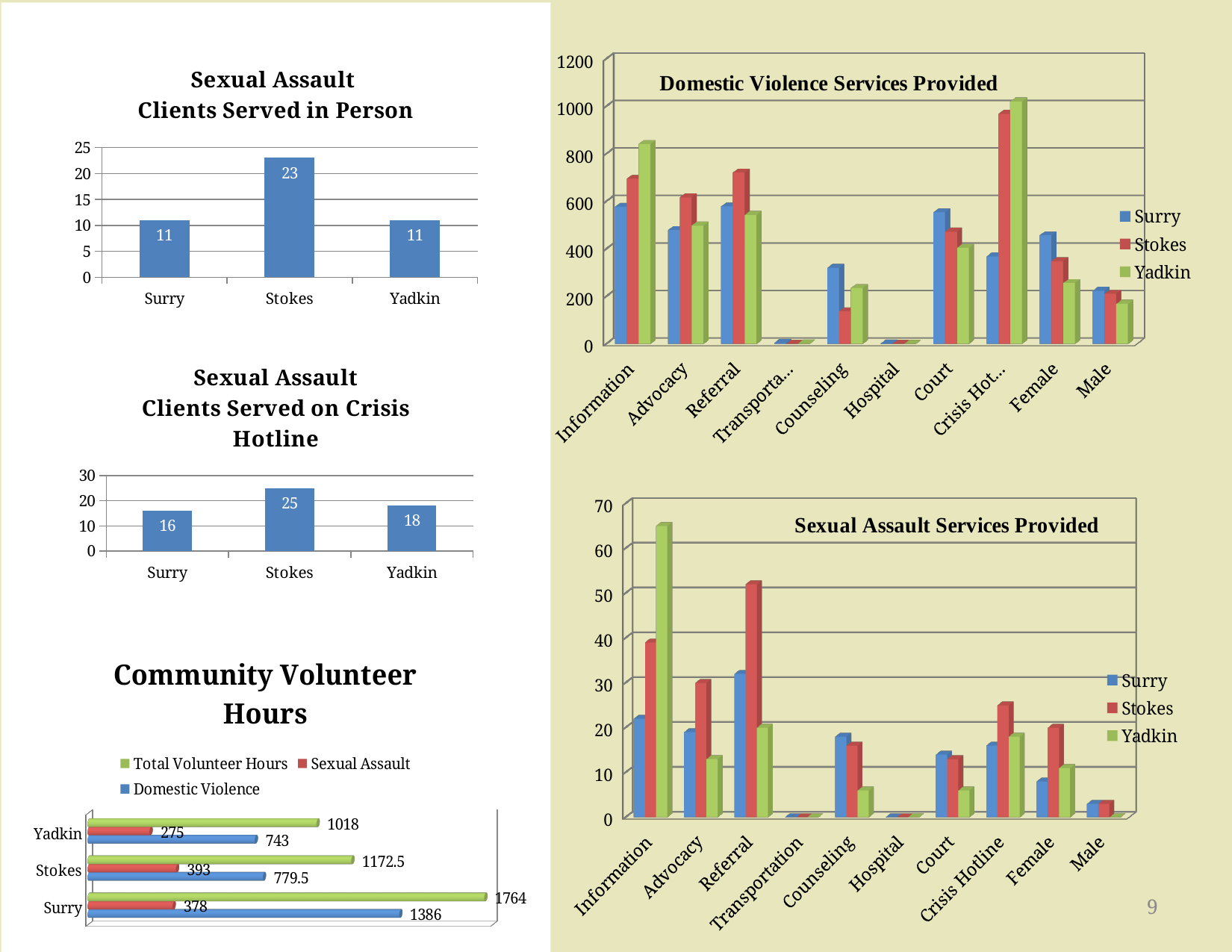
In the 'Domestic Violence Services Provided' chart, how many categories are shown on the x axis? 10 In the 'Community Volunteer Hours' chart, which is larger: the Sexual Assault value for Stokes or for Yadkin? Stokes In the 'Sexual Assault Services Provided' chart, is the Yadkin value for Information greater or less than 60? greater In the 'Sexual Assault Clients Served on Crisis Hotline' chart, what is the value for Yadkin? 18 In the 'Community Volunteer Hours' chart, how many series does the legend list? 3 In the 'Sexual Assault Clients Served on Crisis Hotline' chart, what is the difference between Stokes and Surry? 9 In the 'Sexual Assault Clients Served in Person' chart, which county has the highest value? Stokes In the 'Sexual Assault Clients Served on Crisis Hotline' chart, which county has the lowest value? Surry In the 'Sexual Assault Clients Served in Person' chart, how many clients were served in Stokes? 23 In the 'Community Volunteer Hours' chart, what is the Domestic Violence value for Surry? 1386 In the 'Community Volunteer Hours' chart, what are the Total Volunteer Hours for Stokes? 1172.5